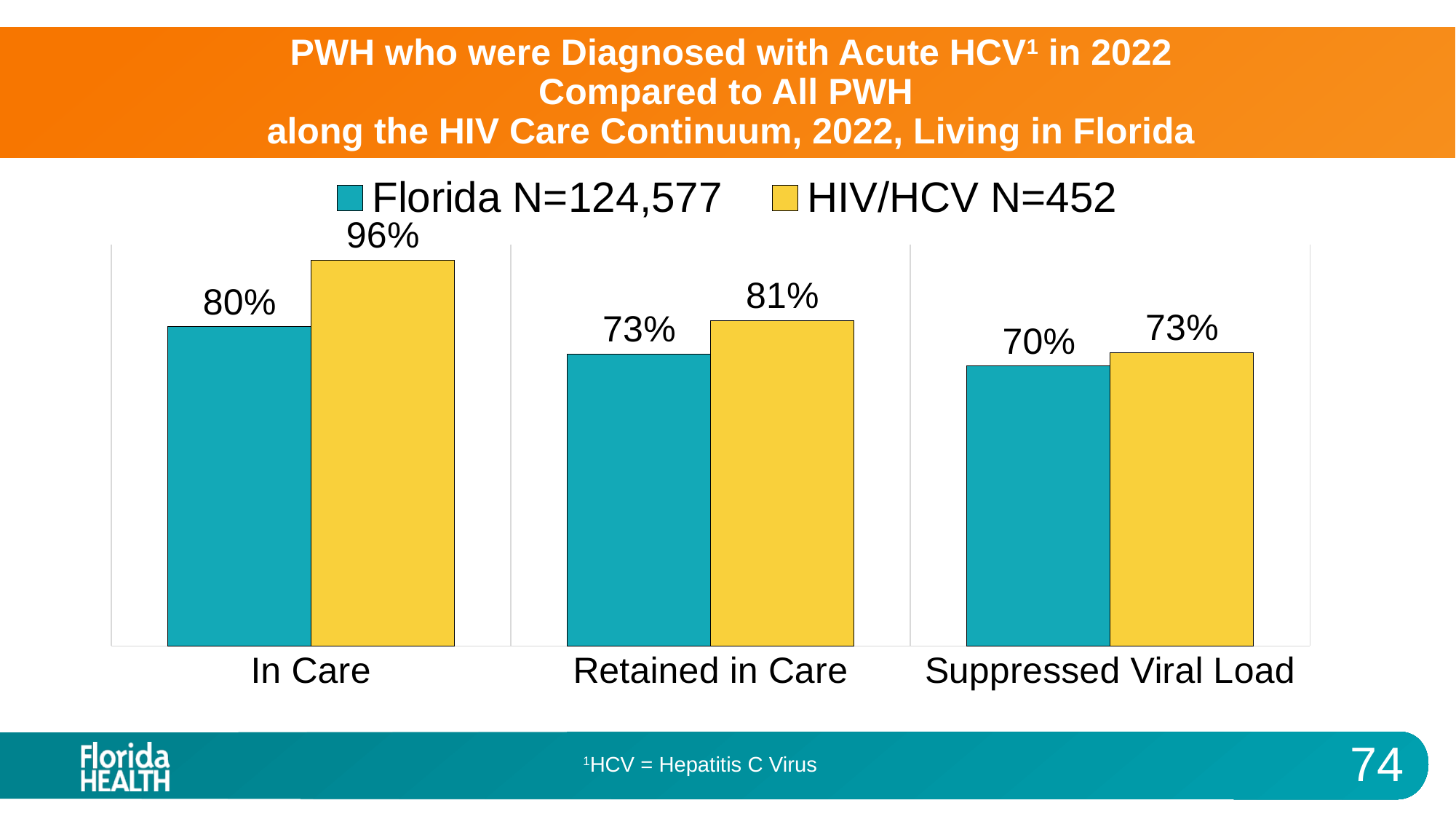
In the Suppressed Viral Load category, which series has the larger value, Florida N=124,577 or HIV/HCV N=452? HIV/HCV N=452 Which category has the highest value for the HIV/HCV N=452 series? In Care What is the difference between the HIV/HCV N=452 and Florida N=124,577 values in the In Care category? 16% How many categories are shown on the x axis? 3 What is the value for HIV/HCV N=452 in the Suppressed Viral Load category? 73% What is the value for Florida N=124,577 in the In Care category? 80% What is the difference between the HIV/HCV N=452 and Florida N=124,577 values in the Retained in Care category? 8% What is the value for HIV/HCV N=452 in the In Care category? 96% What kind of chart is shown on the slide? Bar chart How many series does the legend list? 2 What is the value for Florida N=124,577 in the Retained in Care category? 73% Which category has the lowest value for the Florida N=124,577 series? Suppressed Viral Load